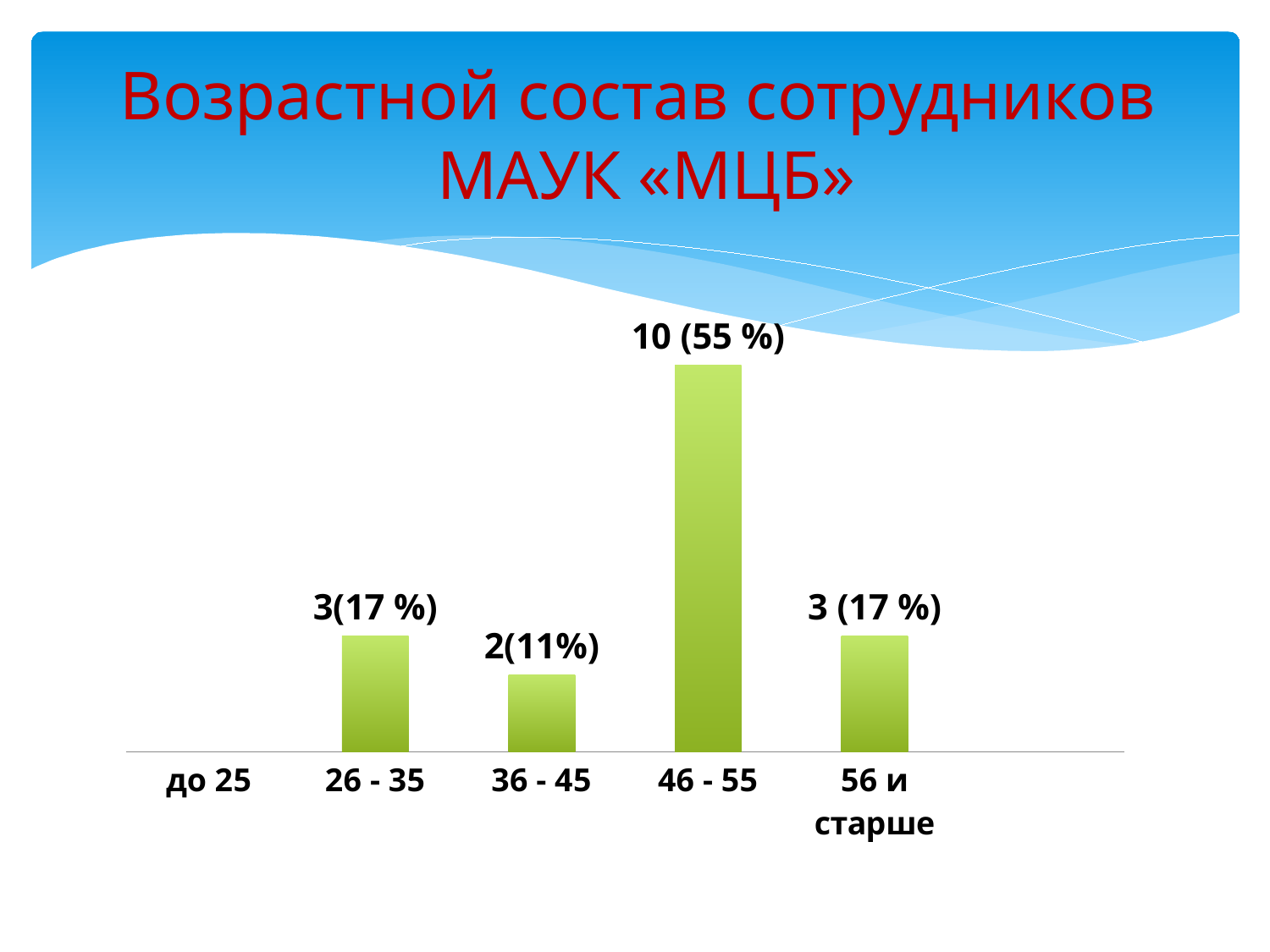
What is the data label for the 46 - 55 age group? 10 (55 %) How many age categories are shown on the x axis? 5 What kind of chart is shown on the slide? Bar chart What is the data label for the 56 и старше age group? 3 (17 %) How many more employees are in the 46 - 55 group than in the 26 - 35 group? 7 Which age group has the highest number of employees? 46 - 55 Which age category has no bar shown on the chart? до 25 What is the data label for the 26 - 35 age group? 3(17 %) What is the data label for the 36 - 45 age group? 2(11%) Which age group has the lowest labelled value among the bars shown? 36 - 45 Which has more employees, the 26 - 35 group or the 36 - 45 group? 26 - 35 What is the title of the chart on the slide? Возрастной состав сотрудников МАУК «МЦБ»